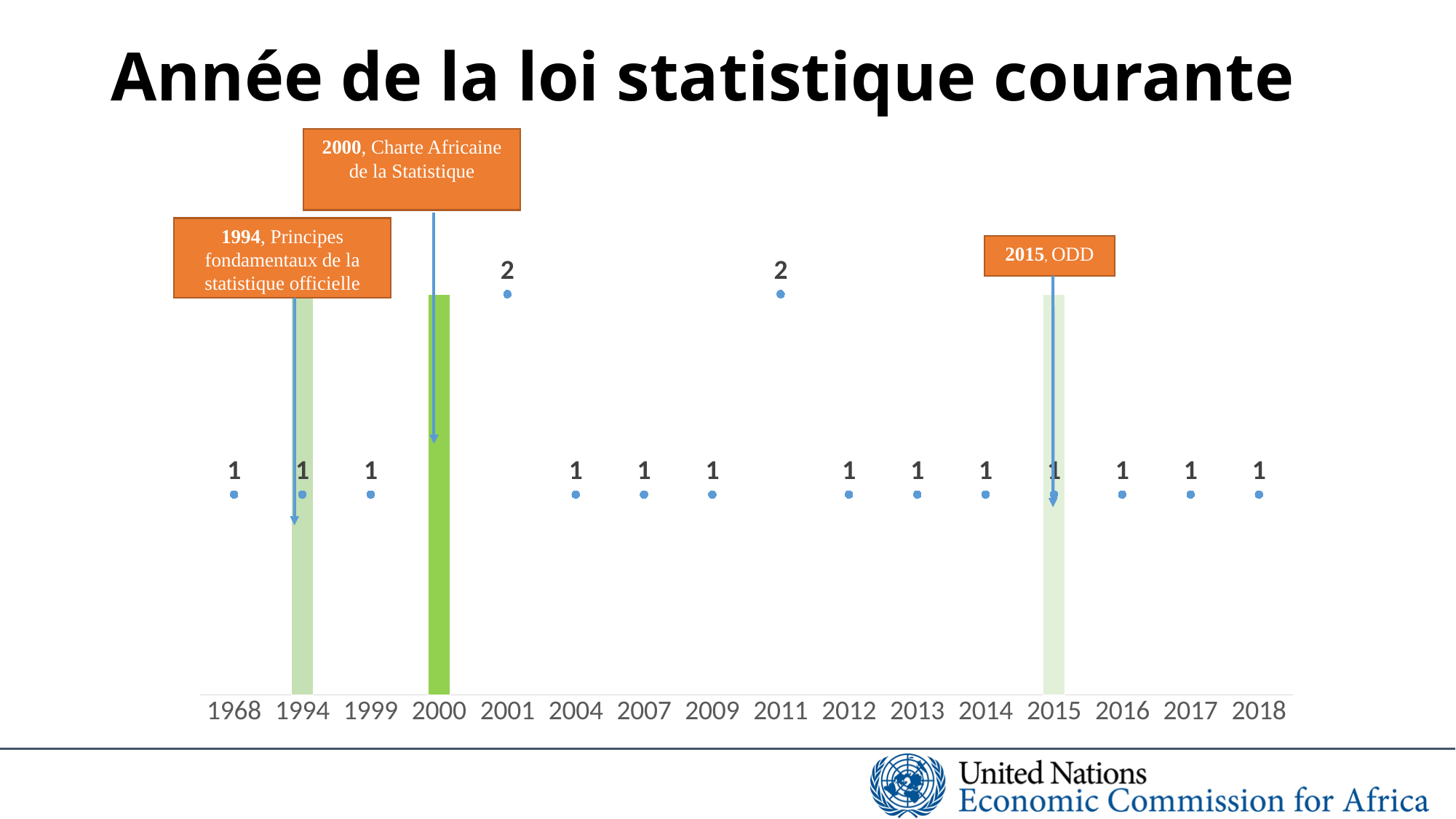
What event does the annotation box for 2000 name? Charte Africaine de la Statistique How many years are labelled on the x axis? 16 What is the value plotted for 1968? 1 What kind of chart is shown on the slide? combination bar and line chart (line drawn as markers only) What is the value plotted for 2018? 1 What is the value plotted for 2011? 2 What is the difference between the values for 2001 and 2004? 1 What is the title of the slide? Année de la loi statistique courante What is the value plotted for 2001? 2 Which has the larger value, 2011 or 2012? 2011